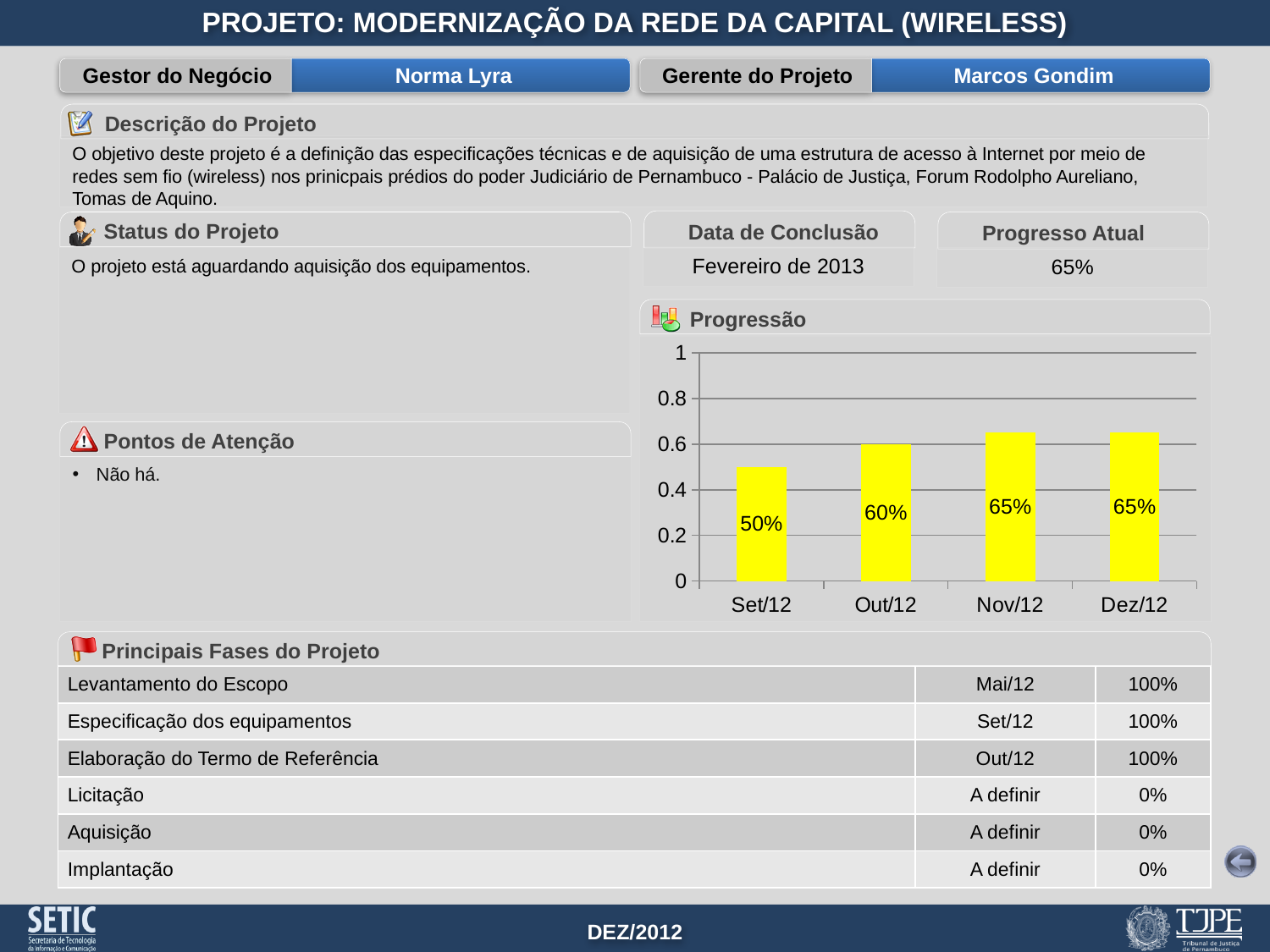
Which month has the lowest value in the Progressão chart? Set/12 What is the value for Out/12 in the Progressão chart? 60% What kind of chart is the Progressão chart? bar chart What is the value for Nov/12 in the Progressão chart? 65% What is the value for Set/12 in the Progressão chart? 50% What is the difference between the values for Out/12 and Set/12 in the Progressão chart? 10% Which is larger in the Progressão chart, the value for Out/12 or the value for Set/12? Out/12 What is the value for Dez/12 in the Progressão chart? 65% Do the values in the Progressão chart rise or fall from Set/12 to Nov/12? rise Is the value for Set/12 in the Progressão chart greater or less than 0.6? less What is the difference between the values for Nov/12 and Set/12 in the Progressão chart? 15% How many months are shown on the x axis of the Progressão chart? 4